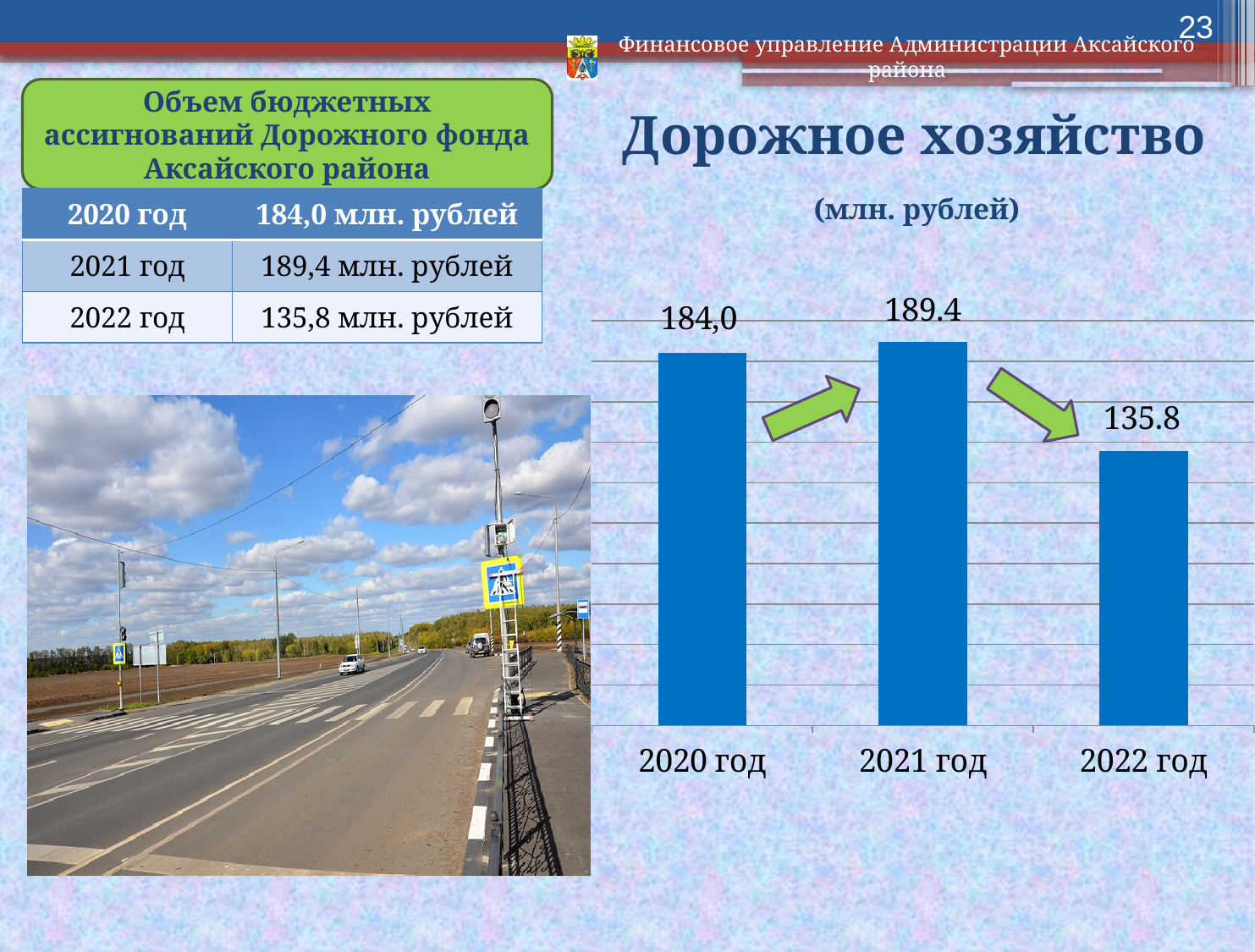
What is the title of the chart? Дорожное хозяйство Which year has the highest value on the chart? 2021 год What kind of chart is shown on the slide? Bar chart What is the value shown for 2020 год on the chart? 184,0 How many years (categories) are shown on the chart? 3 What is the value shown for 2021 год on the chart? 189.4 What is the value shown for 2022 год on the chart? 135.8 What is the difference between the values for 2021 год and 2022 год? 53.6 Does the value fall or rise from 2021 год to 2022 год? Fall What is the difference between the values for 2021 год and 2020 год? 5.4 Which year has the lowest value on the chart? 2022 год Which is larger, the value for 2020 год or the value for 2022 год? 2020 год